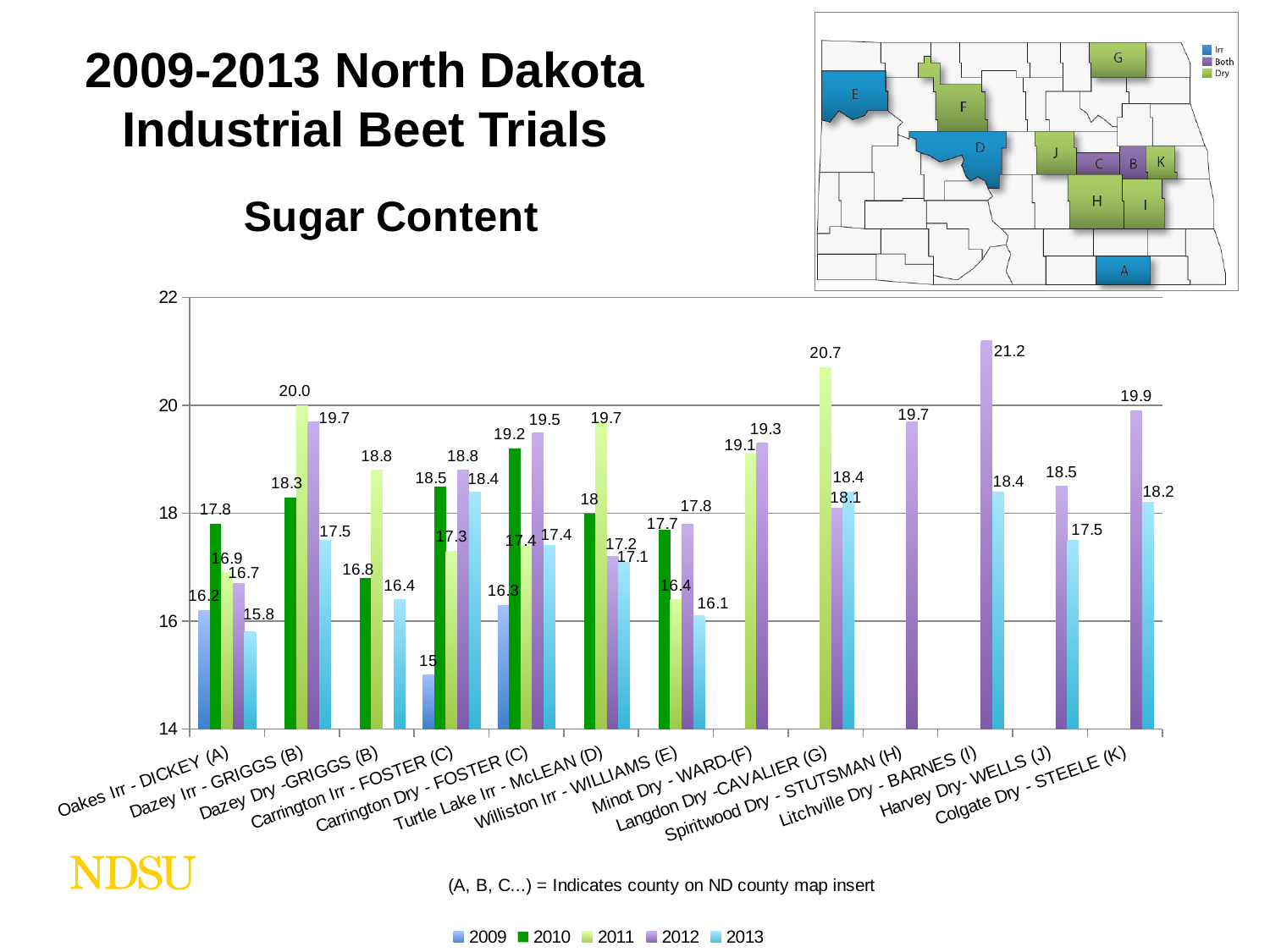
Which is larger for Carrington Dry - FOSTER (C): the 2010 value or the 2012 value? 2012 How many locations are shown on the x axis? 13 Which location and year has the highest sugar content on the chart? Litchville Dry - BARNES (I), 2012 What kind of chart is used to show sugar content? bar chart What is the 2009 value for Carrington Irr - FOSTER (C)? 15 What is the 2011 sugar content value for Langdon Dry - CAVALIER (G)? 20.7 Which year has the lowest value for Oakes Irr - DICKEY (A)? 2013 How many years does the legend list? 5 Which colour represents 2012 in the legend? purple Is the 2012 value for Colgate Dry - STEELE (K) greater or less than 20? less What is the difference between the 2011 and 2013 values for Dazey Irr - GRIGGS (B)? 2.5 What is the 2012 sugar content value for Litchville Dry - BARNES (I)? 21.2